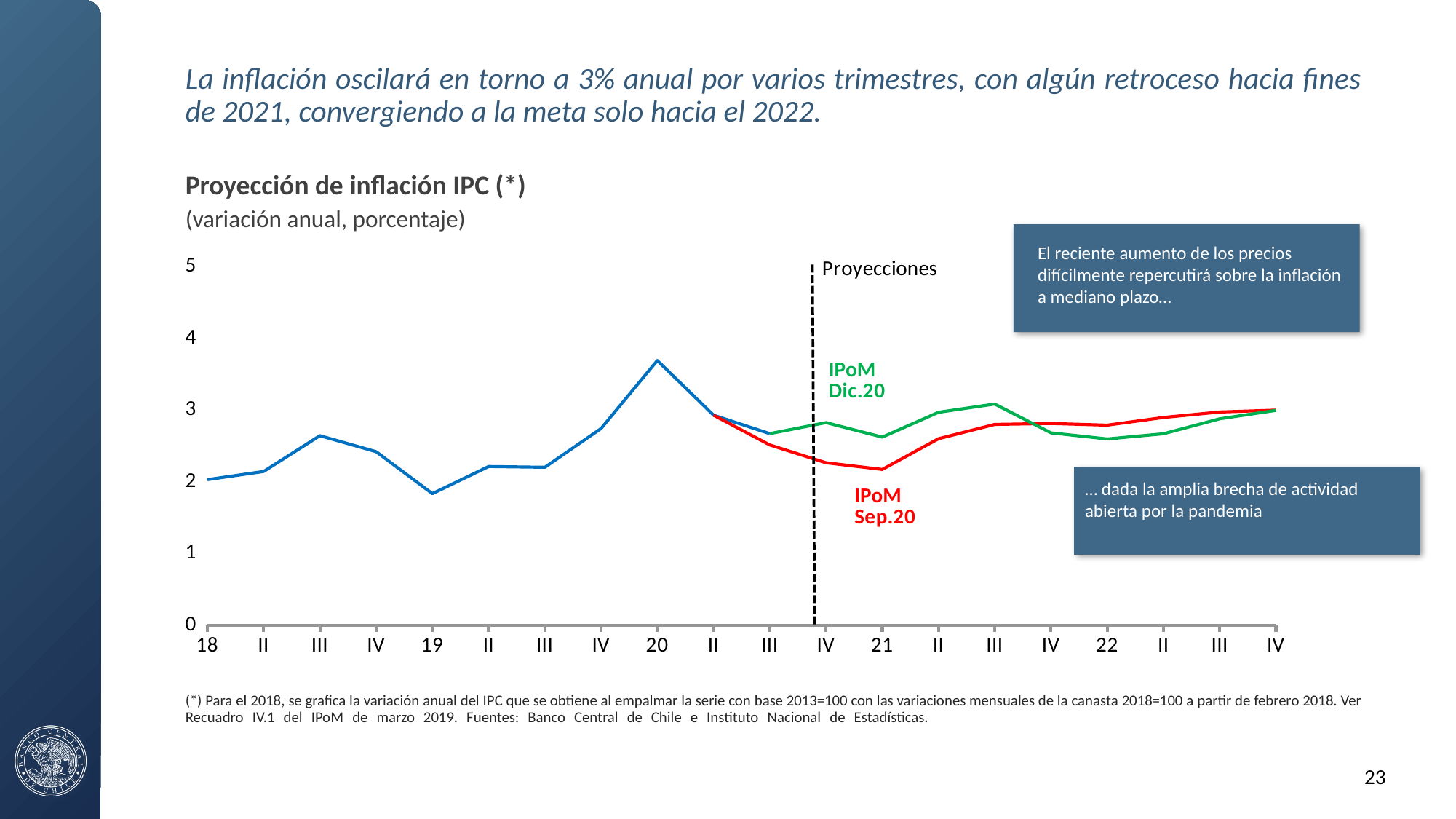
Is the value of the IPoM Sep.20 line at 21 greater or less than 3? less Is the value of the blue line at 19 greater or less than 2? less Which projection series is drawn in red? IPoM Sep.20 Does the IPoM Sep.20 line rise or fall between 21 and III of 2021? rise At 21, which projection is higher, IPoM Dic.20 or IPoM Sep.20? IPoM Dic.20 Is the value of the blue line at 20 greater or less than 3? greater At which x-axis label does the blue line reach its highest value? 20 What is the title of the chart? Proyección de inflación IPC (*) What kind of chart is shown on the slide? line chart How many quarter labels are shown along the x axis? 20 Does the blue line rise or fall between IV of 2019 and 20? rise At which x-axis label does the blue line reach its lowest value? 19